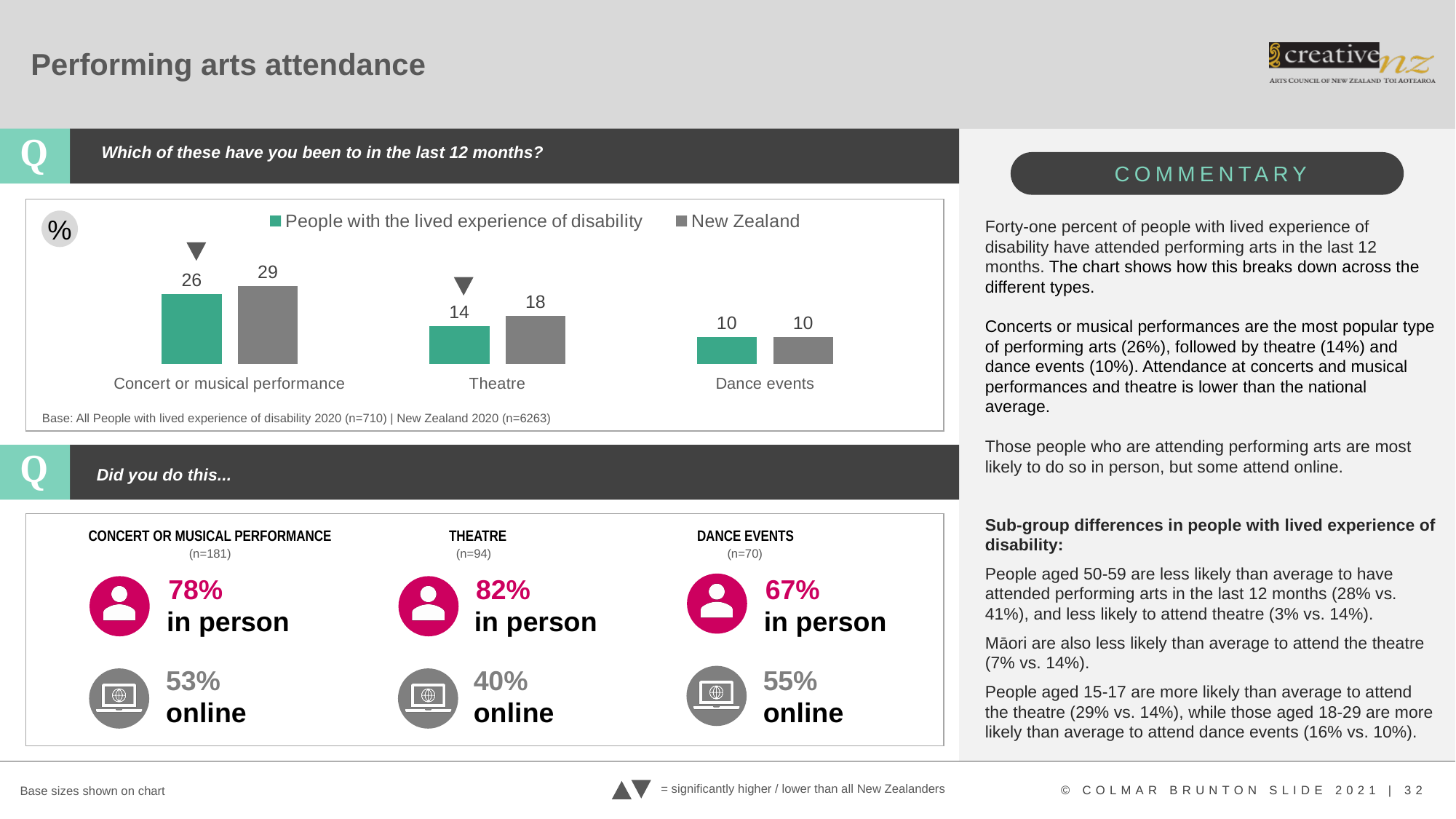
What is the value for People with the lived experience of disability for Dance events? 10 How many series does the chart legend list? 2 What is the value for New Zealand for Theatre? 18 What is the difference between the New Zealand value and the People with the lived experience of disability value for Concert or musical performance? 3 How many categories are shown on the x axis of the chart? 3 Which category has the lowest value for New Zealand? Dance events What is the value for People with the lived experience of disability for Concert or musical performance? 26 Do the values for New Zealand rise or fall from Concert or musical performance to Dance events? Fall For Theatre, which series has the larger value: People with the lived experience of disability or New Zealand? New Zealand What is the difference between the New Zealand value and the People with the lived experience of disability value for Theatre? 4 What kind of chart is shown on the slide? Bar chart Which category has the highest value for People with the lived experience of disability? Concert or musical performance